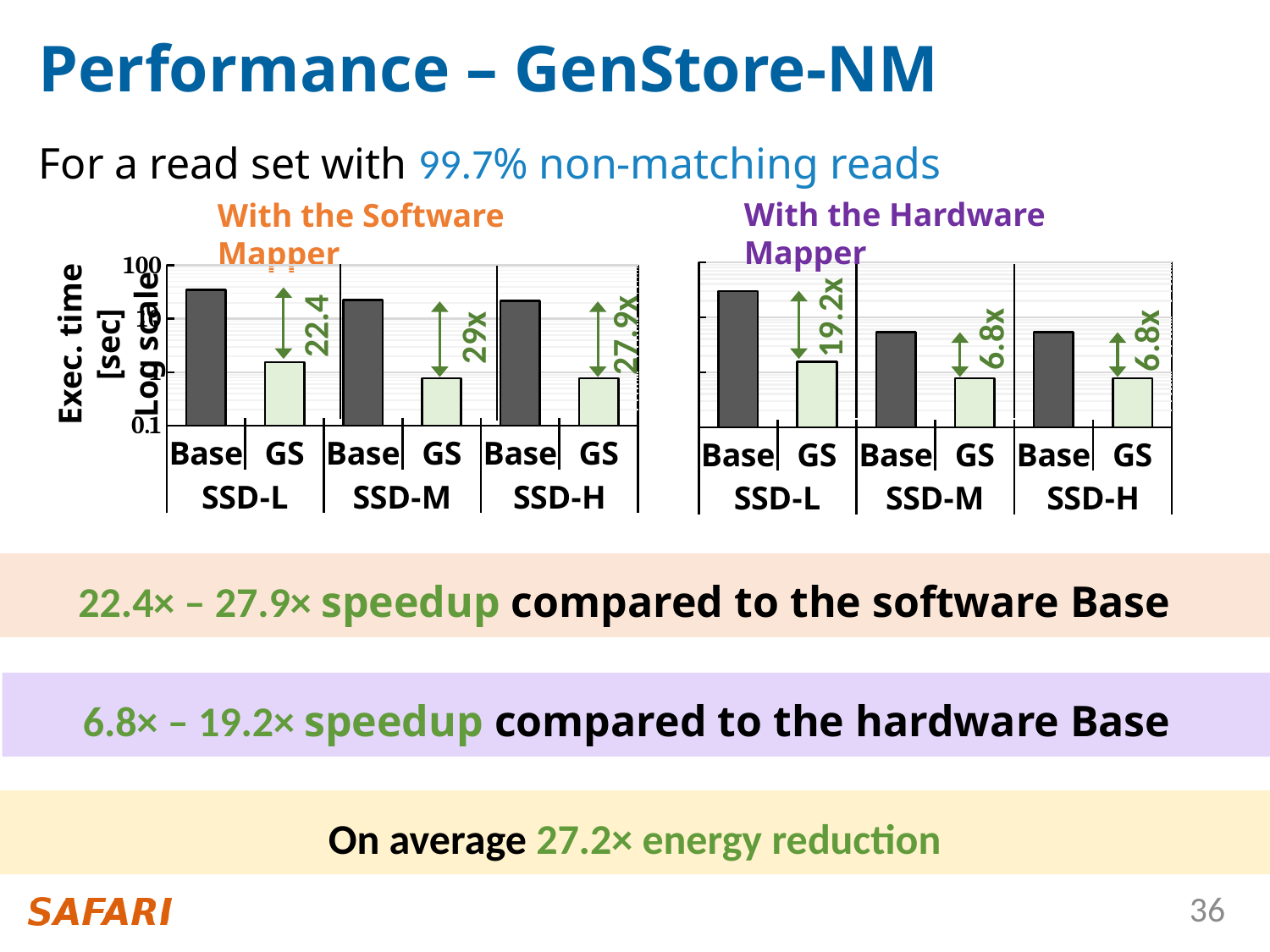
Is the annotated speedup for SSD-L larger in the 'With the Software Mapper' chart or the 'With the Hardware Mapper' chart? With the Software Mapper In the 'With the Hardware Mapper' chart, is the Base execution time for SSD-M greater or less than 10? less In the 'With the Software Mapper' chart, which SSD configuration has the largest annotated speedup? SSD-M In the 'With the Software Mapper' chart, what speedup is annotated for SSD-M? 29x What kind of chart is the 'With the Hardware Mapper' chart? bar chart In the 'With the Hardware Mapper' chart, which SSD configuration has the largest annotated speedup? SSD-L In the 'With the Software Mapper' chart, what speedup is annotated for SSD-H? 27.9x What is the y-axis label of the 'With the Software Mapper' chart? Exec. time [sec] Log scale In the 'With the Software Mapper' chart, is the Base execution time for SSD-L greater or less than 10? greater How many SSD configurations are shown in the 'With the Software Mapper' chart? 3 In the 'With the Hardware Mapper' chart, what speedup is annotated for SSD-L? 19.2x In the 'With the Hardware Mapper' chart, what speedup is annotated for SSD-H? 6.8x